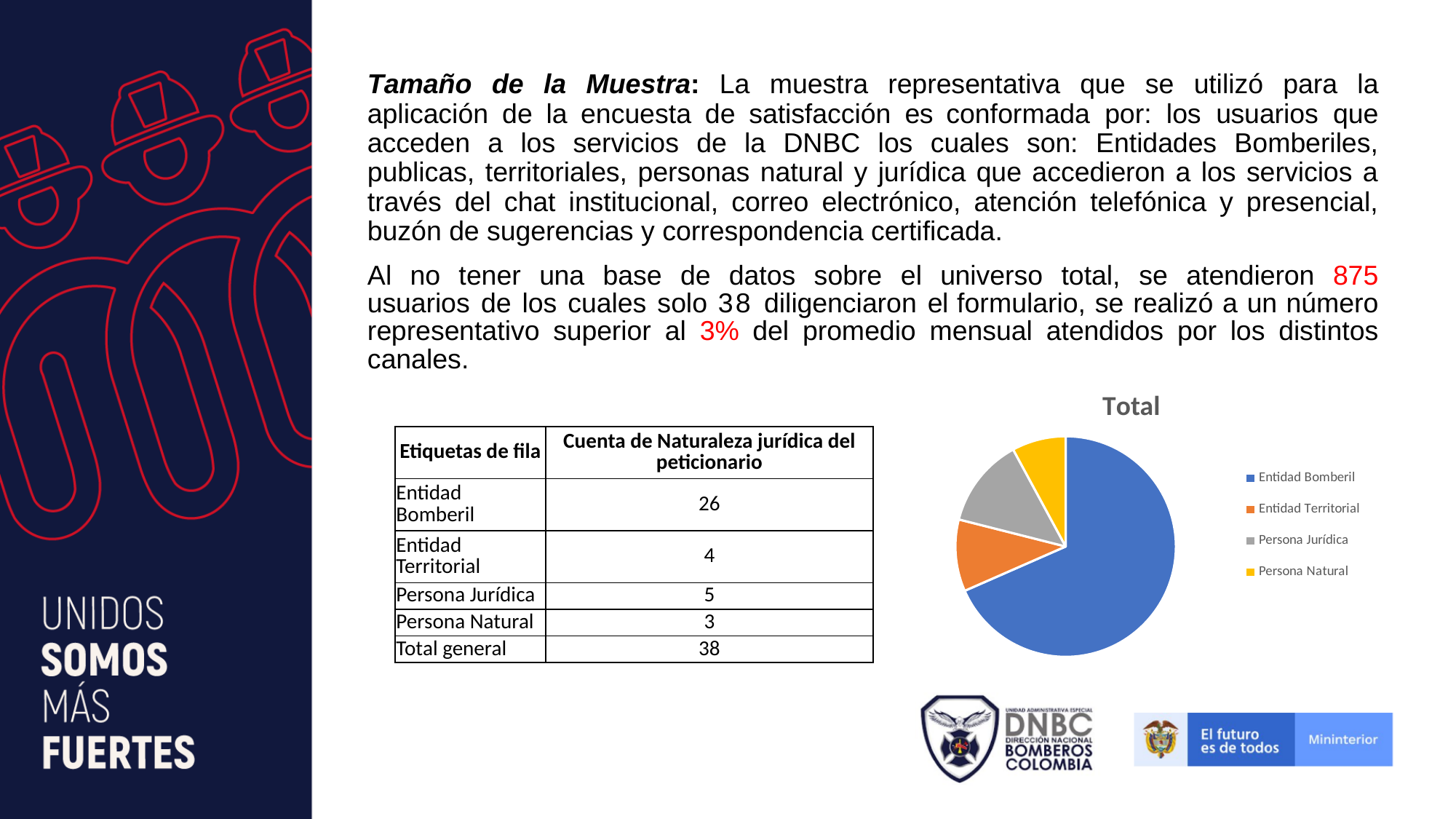
What is the value for Entidad Territorial? 4 What kind of chart is shown on the slide? pie chart What is the value for Persona Jurídica? 5 Which category has the largest slice of the pie chart? Entidad Bomberil Which category has the smallest slice of the pie chart? Persona Natural What is the value for Persona Natural? 3 What is the title of the pie chart? Total How many categories does the pie chart's legend list? 4 Which is larger, the value for Persona Jurídica or the value for Entidad Territorial? Persona Jurídica What is the value for Entidad Bomberil? 26 What is the difference between the values for Entidad Bomberil and Entidad Territorial? 22 What is the total of all four categories in the pie chart? 38